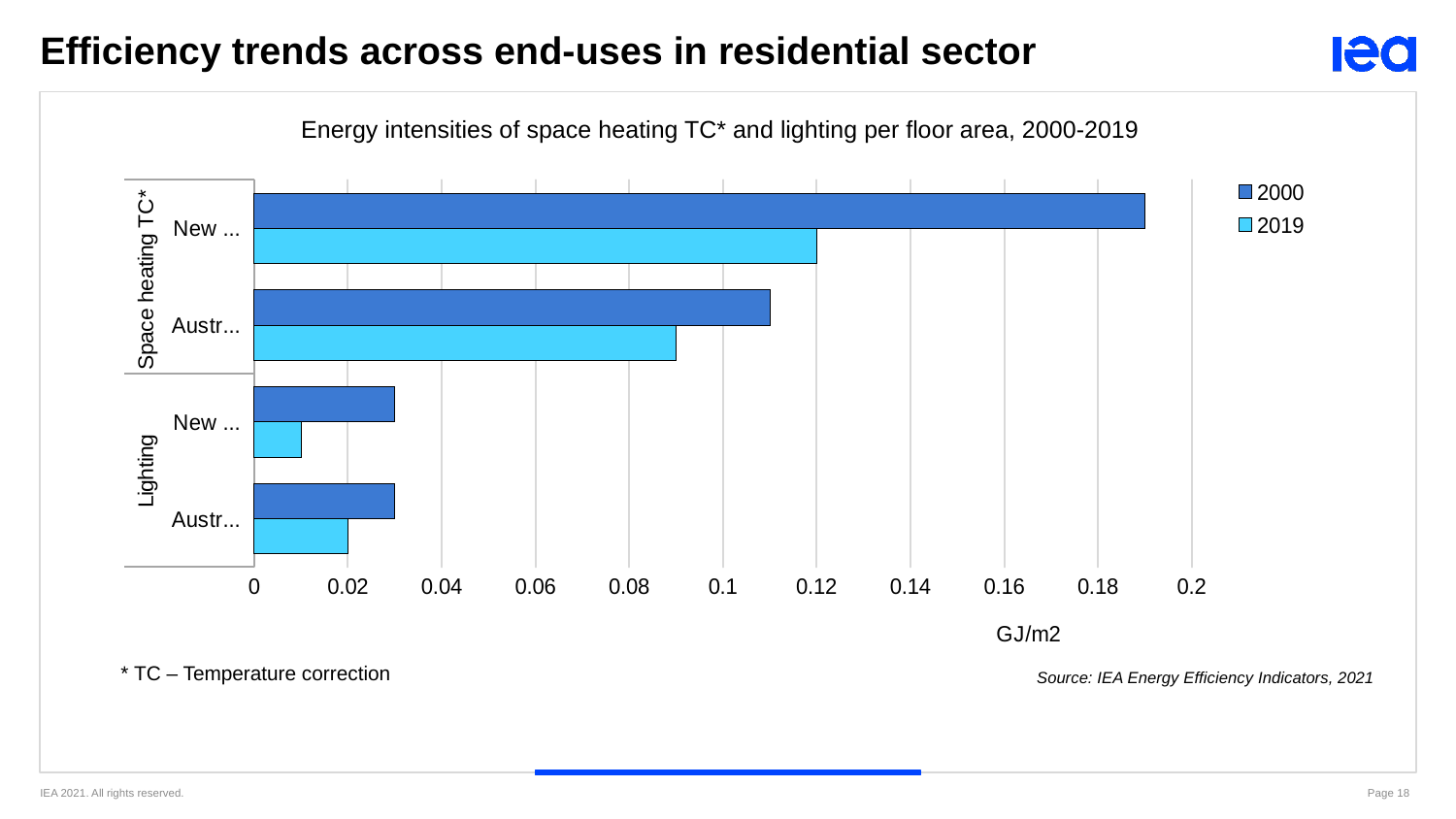
What kind of chart is shown on the slide? Bar chart What is the title of the chart? Energy intensities of space heating TC* and lighting per floor area, 2000-2019 Which bar in the chart is the shortest? 2019 for 'New ...' under Lighting For the 'New ...' category under Space heating TC*, which year has the larger value, 2000 or 2019? 2000 Across all four categories, are the 2019 values higher or lower than the 2000 values? lower Which bar in the chart is the longest? 2000 for 'New ...' under Space heating TC* How many series does the legend list? 2 Is the 2000 value for the 'New ...' category under Space heating TC* greater or less than 0.18? greater Is the 2000 value for the 'New ...' category under Lighting greater or less than 0.04? less Is the 2019 value for the 'Austr...' category under Space heating TC* greater or less than 0.1? less What unit is shown on the x axis of the chart? GJ/m2 How many categories (country bars groups) are plotted in the chart? 4